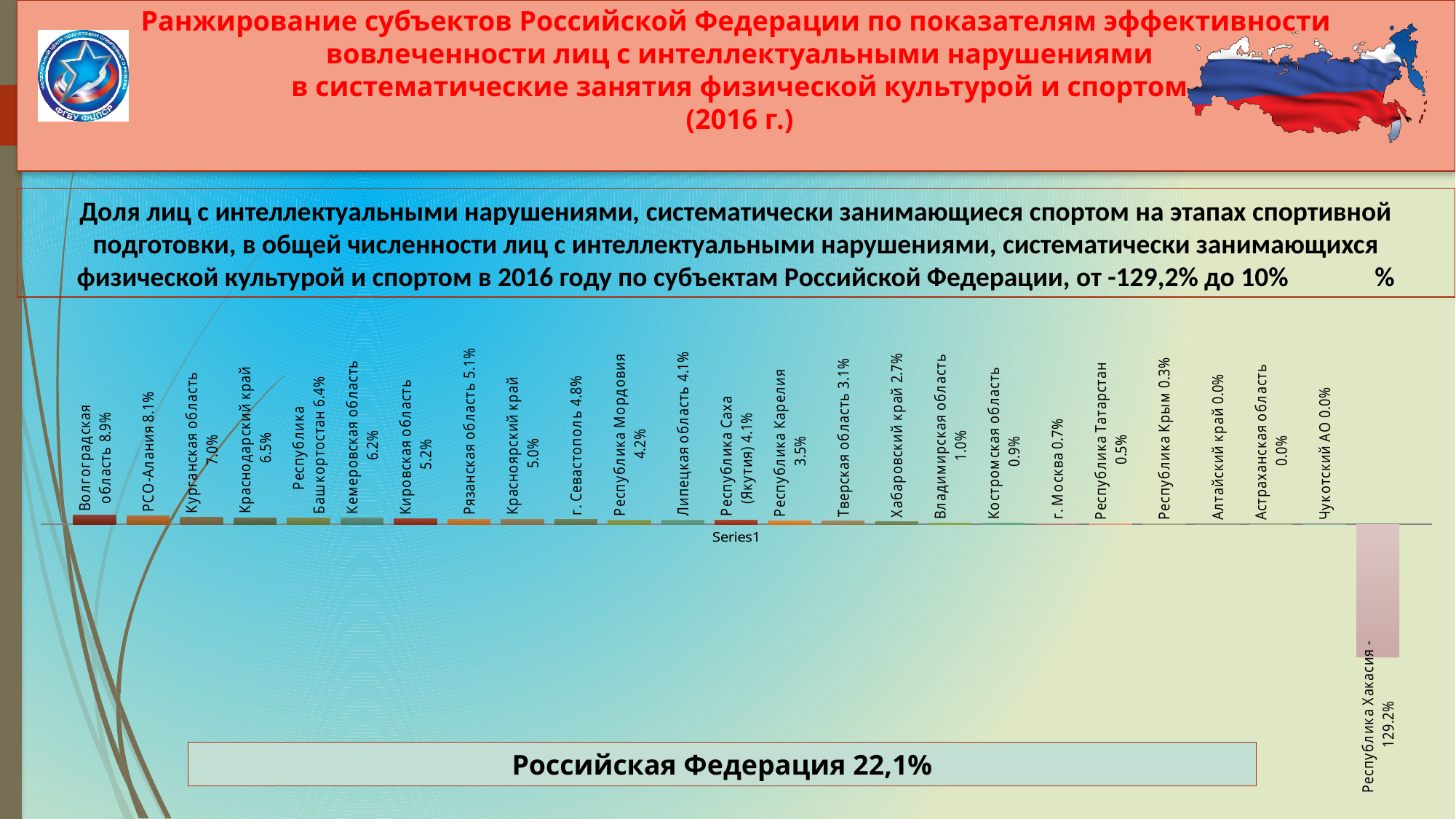
Which region has the highest value in the chart? Волгоградская область What value is given for the Российская Федерация in the box below the chart? 22,1% Which is larger, the value for Кировская область or the value for Тверская область? Кировская область What is the value for Республика Карелия? 3.5% How many regions (categories) are plotted in the chart? 25 What is the value for Республика Хакасия? -129.2% What is the value for г. Москва? 0.7% What type of chart is shown on the slide? bar chart What is the difference between the values for Волгоградская область and РСО-Алания? 0.8% Which region has the lowest value in the chart? Республика Хакасия What is the value for Волгоградская область? 8.9% How many series does the chart legend list? 1